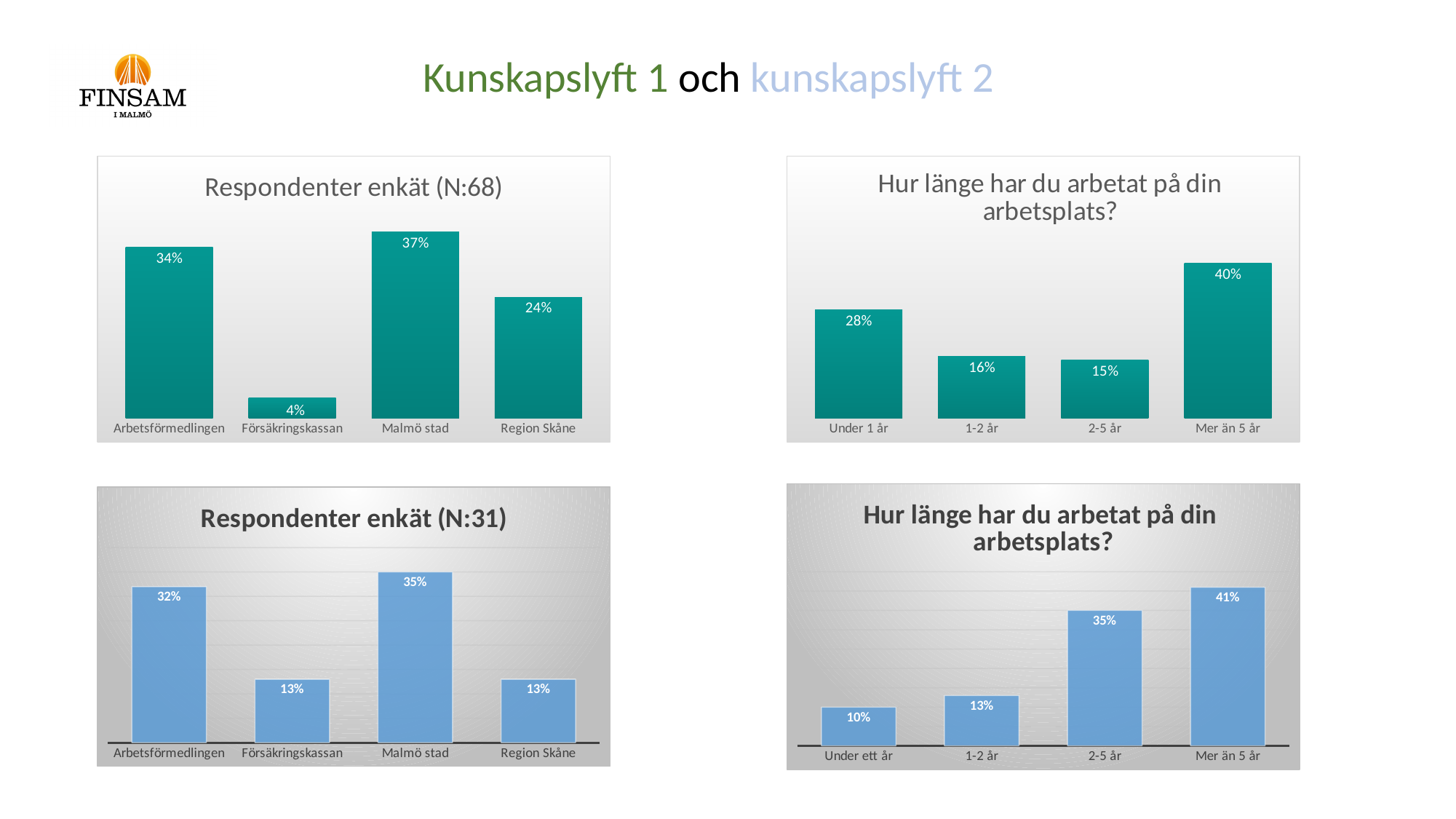
In the 'Respondenter enkät (N:31)' chart, how many categories are shown? 4 In the 'Respondenter enkät (N:68)' chart, what is the difference between Arbetsförmedlingen and Region Skåne? 10% In the top-right chart 'Hur länge har du arbetat på din arbetsplats?', which category has the highest value? Mer än 5 år In the bottom-right chart 'Hur länge har du arbetat på din arbetsplats?', what is the value for '2-5 år'? 35% In the top-right chart 'Hur länge har du arbetat på din arbetsplats?', what is the difference between 'Under 1 år' and '2-5 år'? 13% In the 'Respondenter enkät (N:68)' chart, which category has the lowest value? Försäkringskassan In the 'Respondenter enkät (N:68)' chart, what is the value for Malmö stad? 37% In the top-right chart 'Hur länge har du arbetat på din arbetsplats?', what is the value for 'Mer än 5 år'? 40% In the bottom-right chart 'Hur länge har du arbetat på din arbetsplats?', which category has the lowest value? Under ett år What type of chart is the 'Respondenter enkät (N:68)' chart? Bar chart In the 'Respondenter enkät (N:31)' chart, which is larger, Malmö stad or Region Skåne? Malmö stad In the 'Respondenter enkät (N:31)' chart, what is the value for Arbetsförmedlingen? 32%